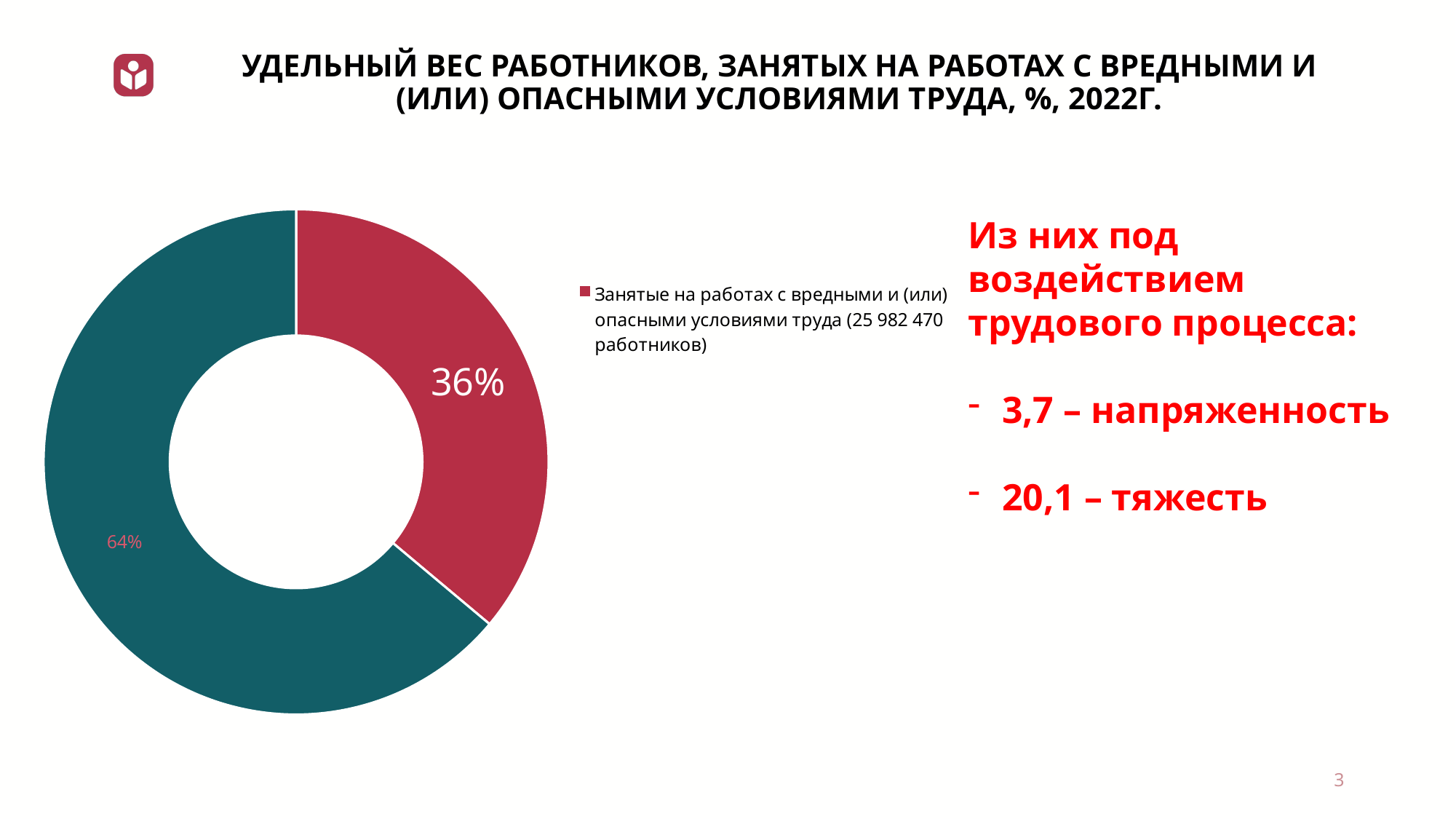
Is the share of workers employed in harmful and/or dangerous working conditions greater or less than 50%? less How many workers are stated in the legend entry for those employed in harmful and/or dangerous working conditions? 25 982 470 работников How many entries does the chart legend list? 1 What colour is the slice for 'Занятые на работах с вредными и (или) опасными условиями труда'? Red What is the total of the two slices shown in the pie chart? 100% How many slices does the pie chart have? 2 What share of the pie is taken by the slice 'Занятые на работах с вредными и (или) опасными условиями труда'? 36% What kind of chart is shown on the slide? Pie chart (donut) What is the smallest slice in the pie chart? 36% (Занятые на работах с вредными и (или) опасными условиями труда) What percentage is shown on the teal (larger) slice of the chart? 64% What is the difference in percentage points between the teal slice (64%) and the red slice (36%)? 28 Which slice is larger: the red slice or the teal slice? The teal slice